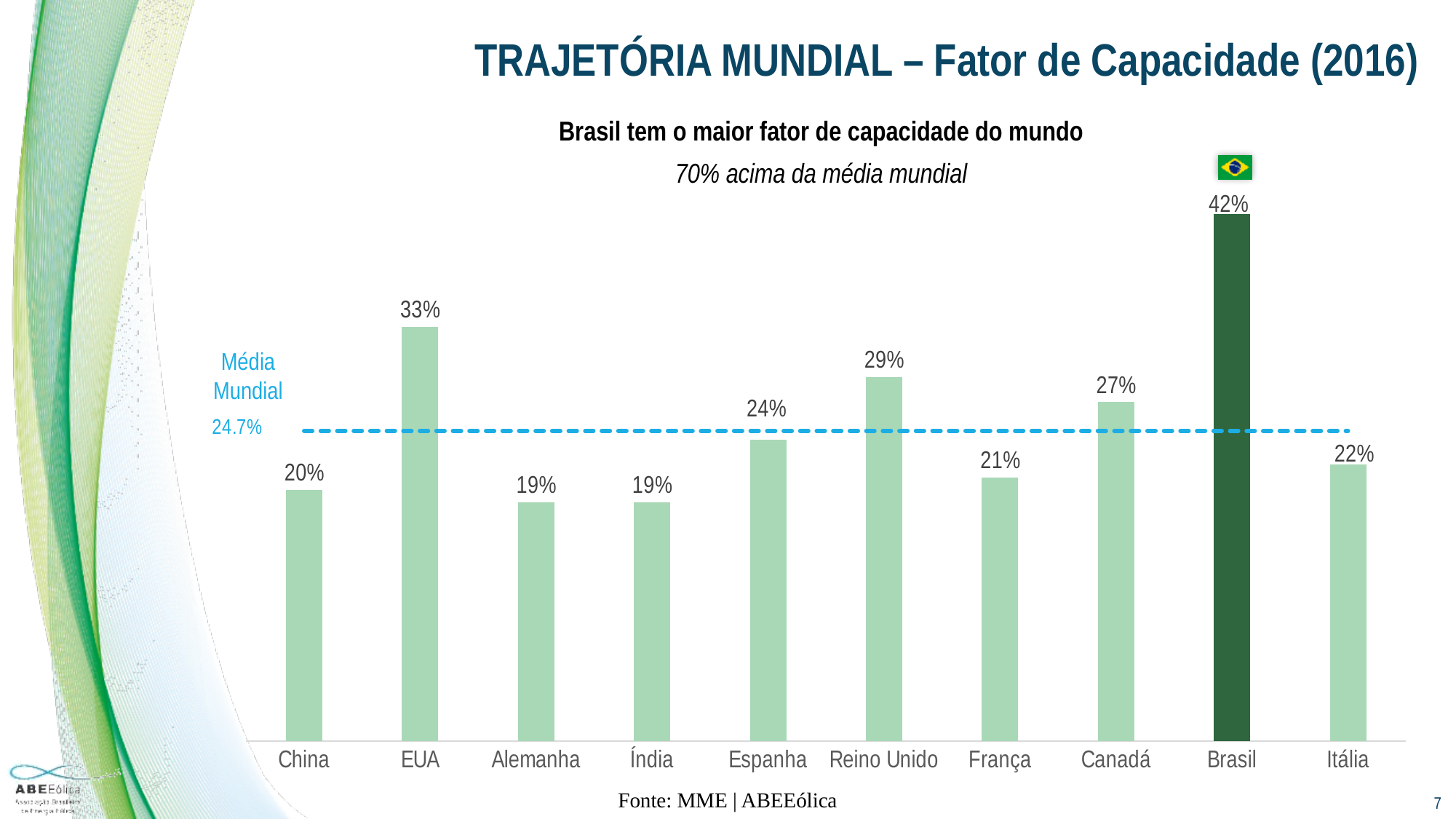
How many countries are shown on the chart? 10 What is the capacity factor shown for Brasil? 42% What is the capacity factor shown for EUA? 33% What value is given for the world average (Média Mundial) dashed line? 24.7% What is the difference between the capacity factors of Brasil and EUA? 9% What kind of chart is shown on the slide? Bar chart What is the capacity factor shown for Reino Unido? 29% Which country has the highest capacity factor on the chart? Brasil Which countries share the lowest capacity factor on the chart? Alemanha and Índia What is the difference between the capacity factors of Canadá and França? 6% Which country's bar is drawn in a darker green than the others? Brasil Which has a higher capacity factor, Espanha or Itália? Espanha